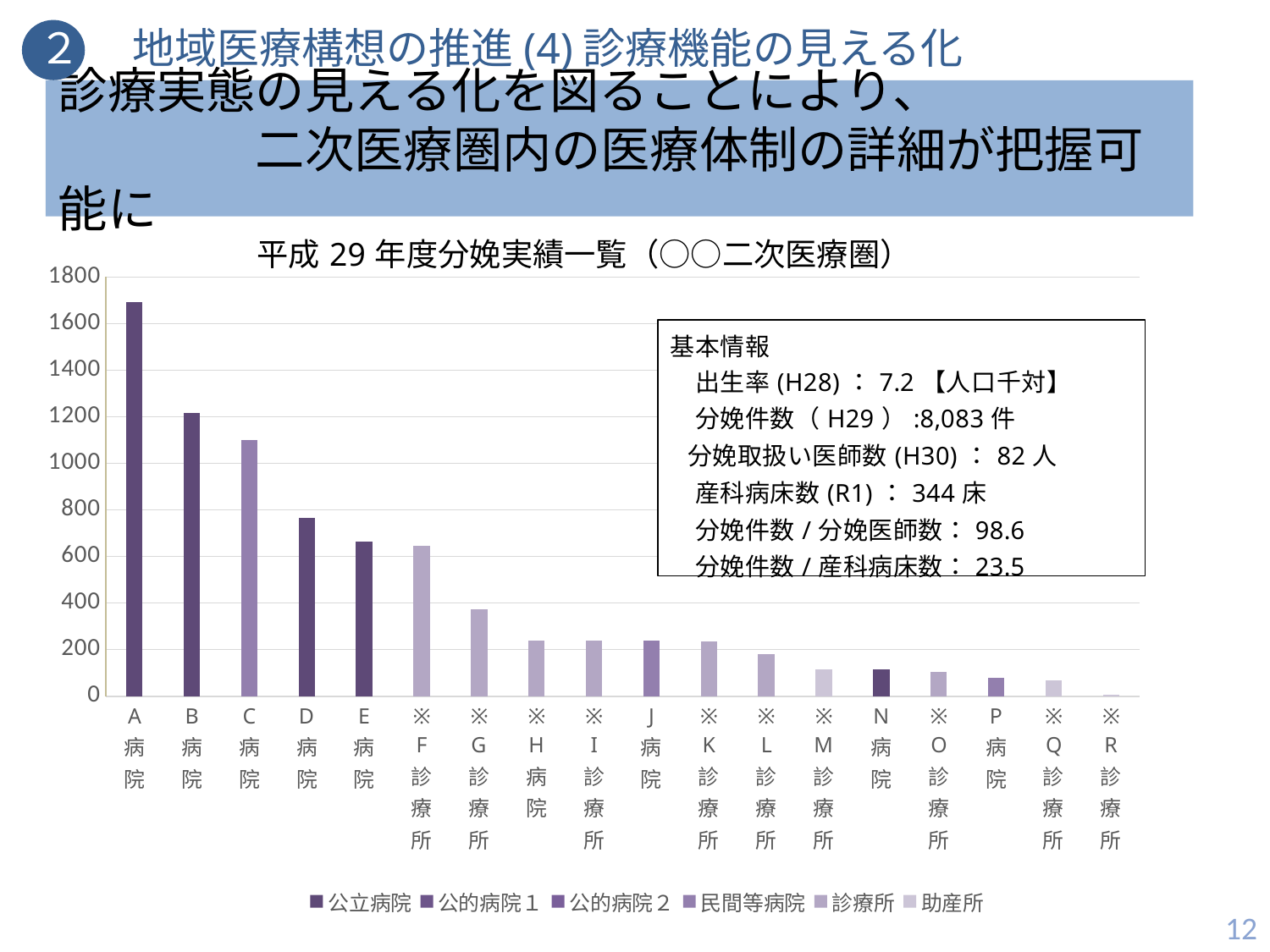
Is the value for A病院 greater or less than 1600? greater Is the value for C病院 greater or less than 1000? greater Do the values generally rise or fall moving from left to right along the x axis? fall What is the title of the chart? 平成29年度分娩実績一覧（○○二次医療圏） How many categories are plotted along the x axis of the chart? 18 Is the value for ※G診療所 greater or less than 400? less Which category has the highest value in the chart? A病院 Which has a larger value, A病院 or B病院? A病院 What kind of chart is shown on the slide? bar chart Which category has the lowest value in the chart? ※R診療所 How many series does the chart's legend list? 6